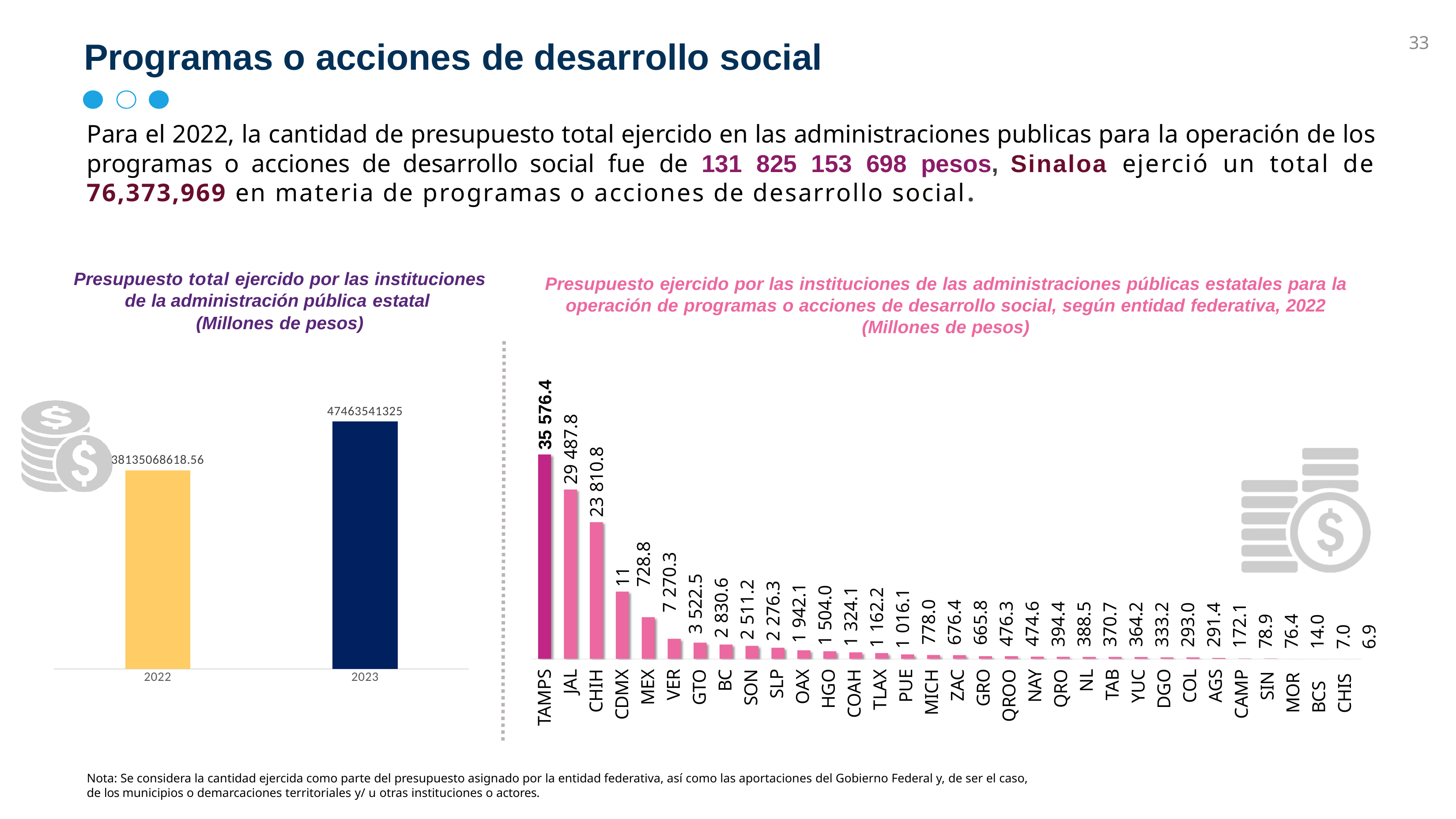
In the left chart, which year has the higher value, 2022 or 2023? 2023 In the right chart (Presupuesto ejercido ... según entidad federativa, 2022), which entity has the lowest value? CHIS In the right chart (Presupuesto ejercido ... según entidad federativa, 2022), which entity has the highest value? TAMPS In the left chart, what is the difference between the 2023 and 2022 values? 9328472706.44 What kind of chart is the right chart (Presupuesto ejercido ... según entidad federativa, 2022)? bar chart In the left chart (Presupuesto total ejercido por las instituciones de la administración pública estatal), what is the value for 2022? 38135068618.56 In the left chart (Presupuesto total ejercido por las instituciones de la administración pública estatal), what is the value for 2023? 47463541325 In the right chart, what is the difference between the values for TAMPS and JAL? 6 088.6 In the right chart (Presupuesto ejercido ... según entidad federativa, 2022), what is the value for TAMPS? 35 576.4 In the right chart, do the values rise or fall from left to right along the x axis? fall In the right chart (Presupuesto ejercido ... según entidad federativa, 2022), what is the value for SIN? 76.4 In the right chart, how many entities (categories) are shown? 32